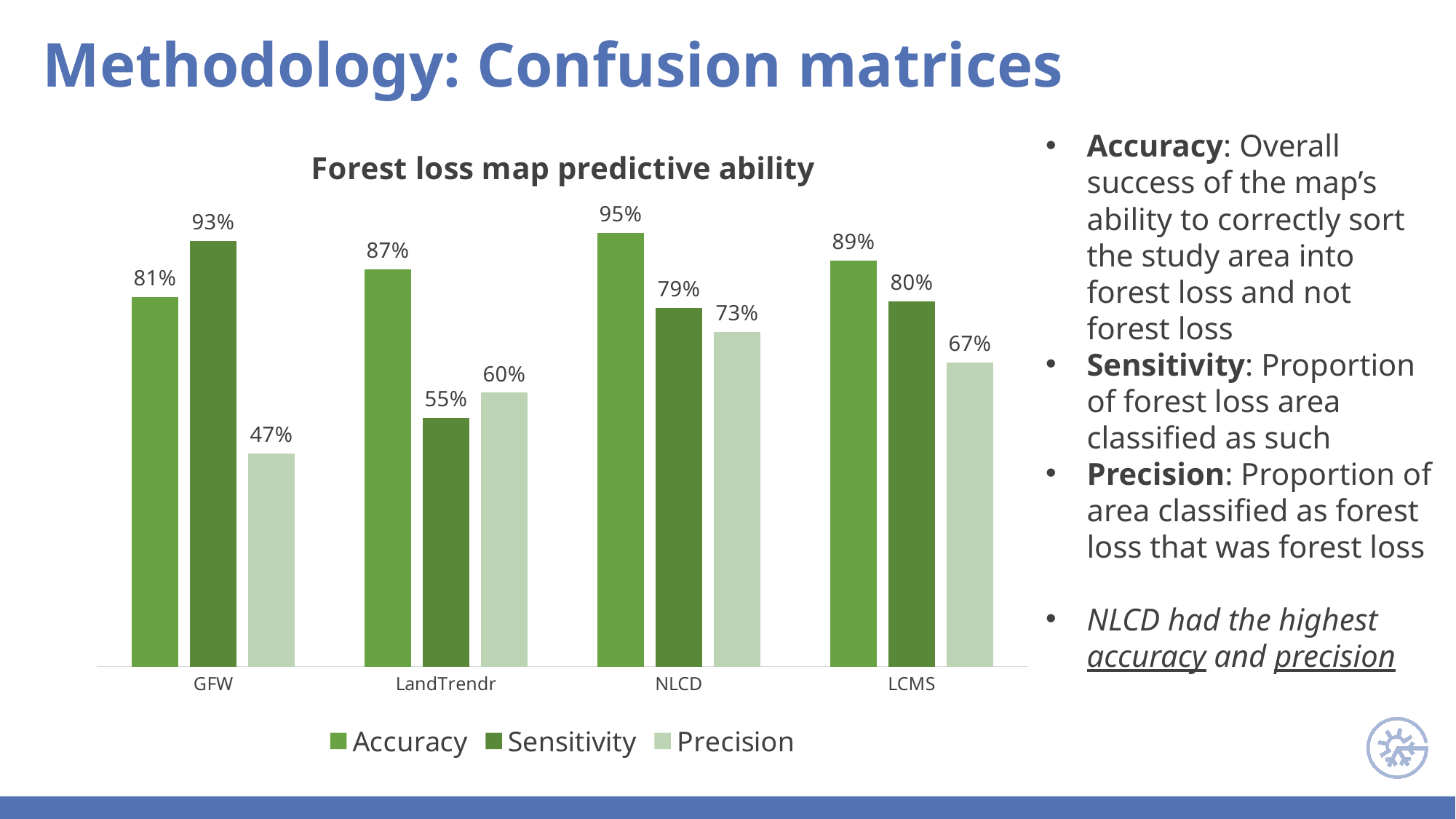
Which is larger, the Sensitivity for NLCD or the Sensitivity for LCMS? Sensitivity for LCMS Which category has the lowest Precision? GFW What is the title of the chart? Forest loss map predictive ability What kind of chart is shown on the slide? Bar chart How many series does the legend list? 3 What is the Sensitivity value for LandTrendr? 55% What is the Precision value for GFW? 47% Which category has the highest Sensitivity? GFW What is the Accuracy value for NLCD? 95% Which series is shown in the lightest green colour? Precision How many categories are shown on the x axis? 4 What is the difference between the Accuracy and Precision values for LCMS? 22%